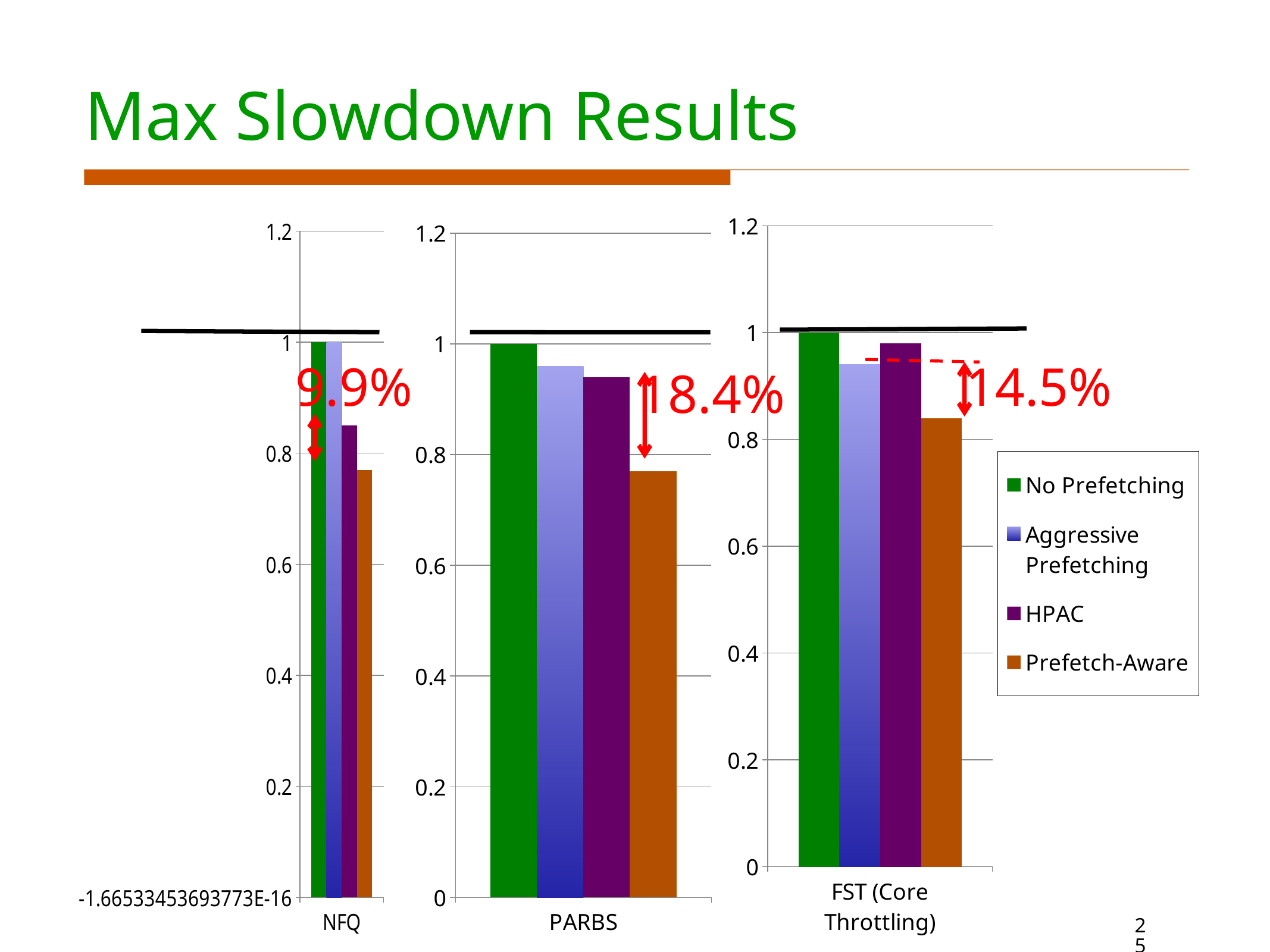
In the PARBS chart, what is the value for No Prefetching? 1 In the FST (Core Throttling) chart, is the value for HPAC greater or less than 0.8? greater How many series does the legend list? 4 In the PARBS chart, do the bars rise or fall from left to right? fall What percentage is annotated in red on the FST (Core Throttling) chart? 14.5% In the PARBS chart, is the value for Prefetch-Aware greater or less than 0.8? less What percentage is annotated in red on the PARBS chart? 18.4% In the NFQ chart, which is larger, HPAC or Prefetch-Aware? HPAC What kind of chart is used on this slide for the NFQ, PARBS and FST results? bar chart In the FST (Core Throttling) chart, which series has the highest value? No Prefetching In the PARBS chart, which series has the lowest value? Prefetch-Aware How many separate charts are shown on the slide? 3